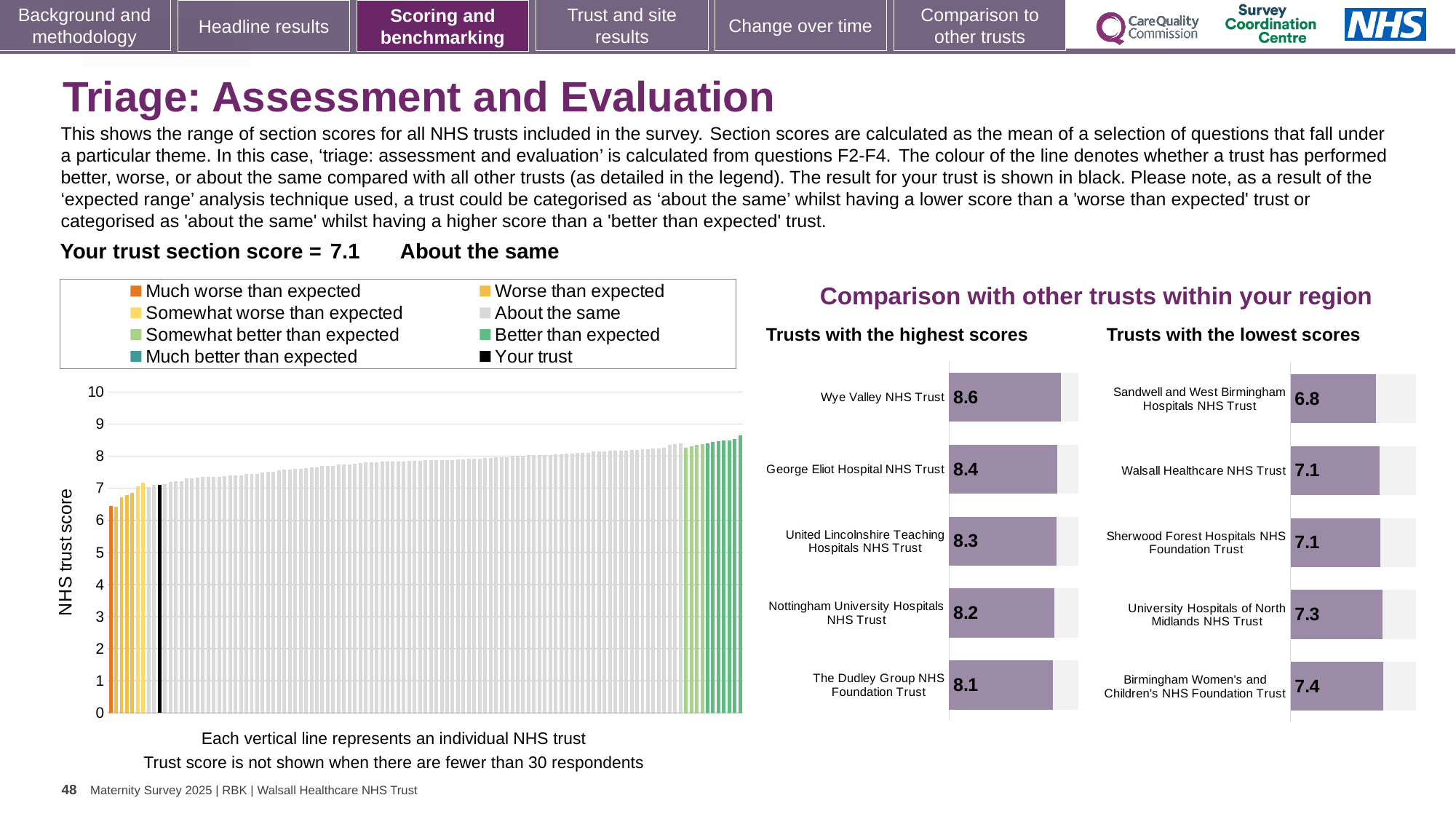
In the 'NHS trust score' chart on the left, is the value of the black bar (your trust) greater or less than 5? greater In the 'Trusts with the lowest scores' chart, how much higher is the score of Birmingham Women's and Children's NHS Foundation Trust than that of Sandwell and West Birmingham Hospitals NHS Trust? 0.6 In the 'Trusts with the lowest scores' chart, which trust has the lowest score? Sandwell and West Birmingham Hospitals NHS Trust What kind of chart is the 'NHS trust score' chart on the left of the slide? bar chart How many trusts are shown in the 'Trusts with the lowest scores' chart? 5 In the 'Trusts with the highest scores' chart, what is the difference between the scores of Wye Valley NHS Trust and The Dudley Group NHS Foundation Trust? 0.5 In the 'Trusts with the highest scores' chart, which has the larger score: George Eliot Hospital NHS Trust or Nottingham University Hospitals NHS Trust? George Eliot Hospital NHS Trust How many entries does the legend of the 'NHS trust score' chart on the left list? 8 In the 'NHS trust score' chart on the left, do the values rise or fall from left to right along the x axis? rise In the 'Trusts with the highest scores' chart, which trust has the highest score? Wye Valley NHS Trust In the 'Trusts with the lowest scores' chart, what is the score for Sandwell and West Birmingham Hospitals NHS Trust? 6.8 In the 'Trusts with the highest scores' chart, what is the score for Wye Valley NHS Trust? 8.6